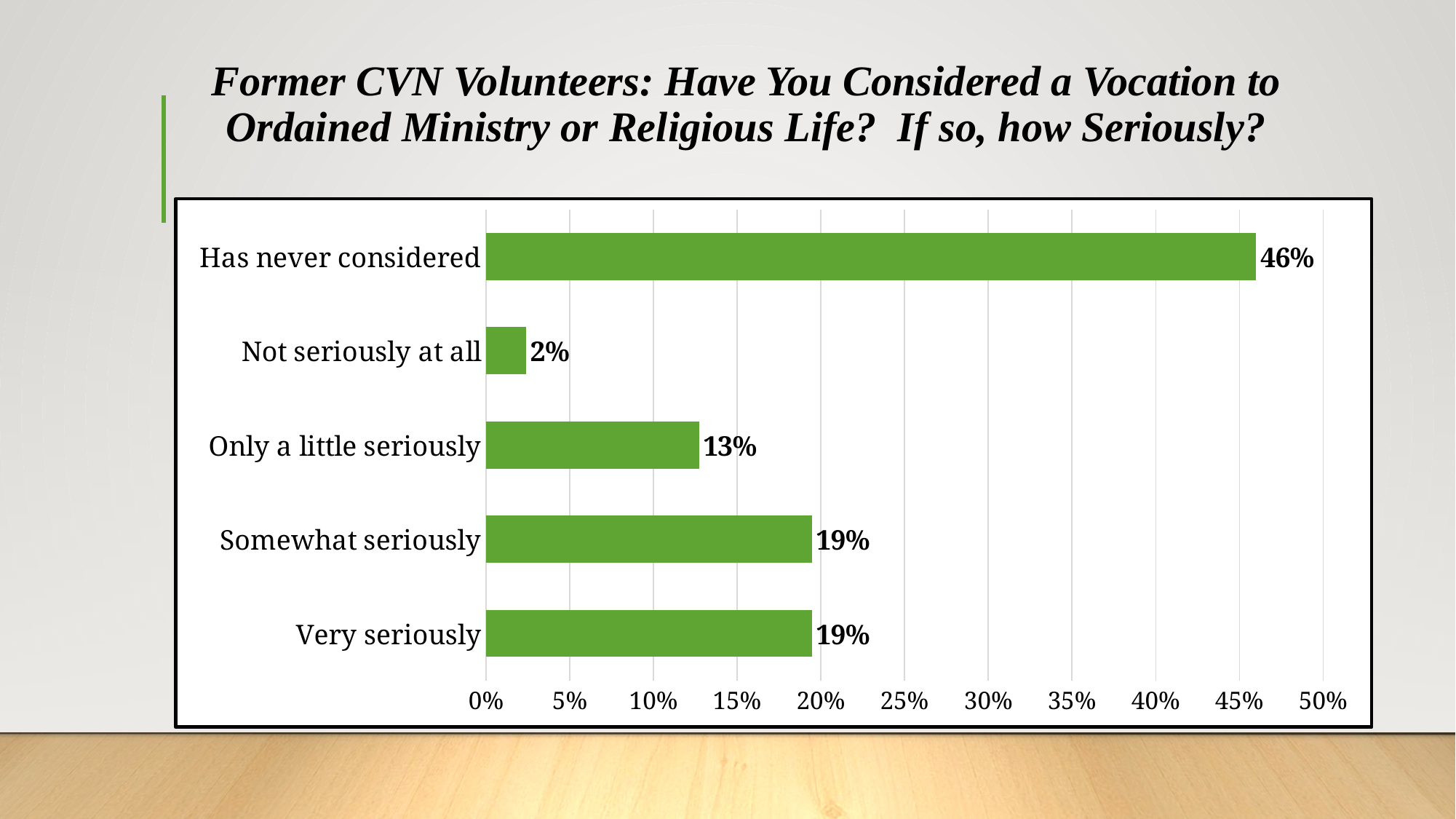
Which is larger, the value for "Only a little seriously" or the value for "Somewhat seriously"? Somewhat seriously Which category has the lowest value? Not seriously at all Which category has the highest value? Has never considered What is the value for "Very seriously"? 19% How many categories are shown in the chart? 5 What is the difference between "Has never considered" and "Somewhat seriously"? 27% What is the value for "Not seriously at all"? 2% What kind of chart is shown on the slide? Bar chart What is the highest value shown on the horizontal axis? 50% What percentage of former CVN volunteers has never considered a vocation to ordained ministry or religious life? 46% What is the value for "Only a little seriously"? 13% What is the difference between "Only a little seriously" and "Not seriously at all"? 11%